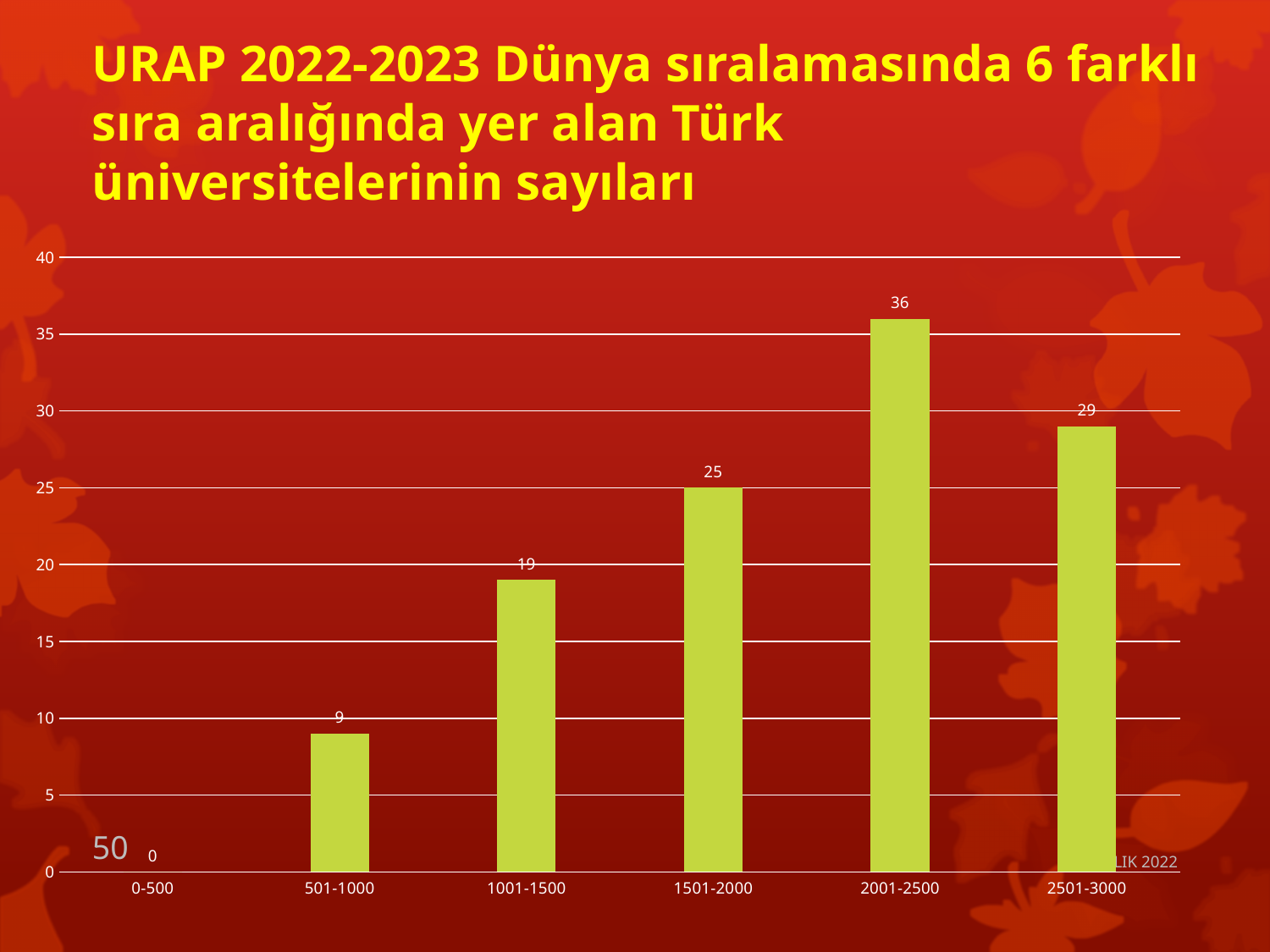
What is the value for the 501-1000 category? 9 Which category has the highest value? 2001-2500 What is the difference between the values for 1501-2000 and 1001-1500? 6 What is the value for the 0-500 category? 0 How many categories are shown on the x axis? 6 What is the value for the 1501-2000 category? 25 What kind of chart is shown on the slide? bar chart Which category has the lowest value? 0-500 Which is larger, the value for 1001-1500 or the value for 2501-3000? 2501-3000 What is the value for the 2001-2500 category? 36 What is the highest value shown on the y axis? 40 What is the difference between the values for 2001-2500 and 2501-3000? 7